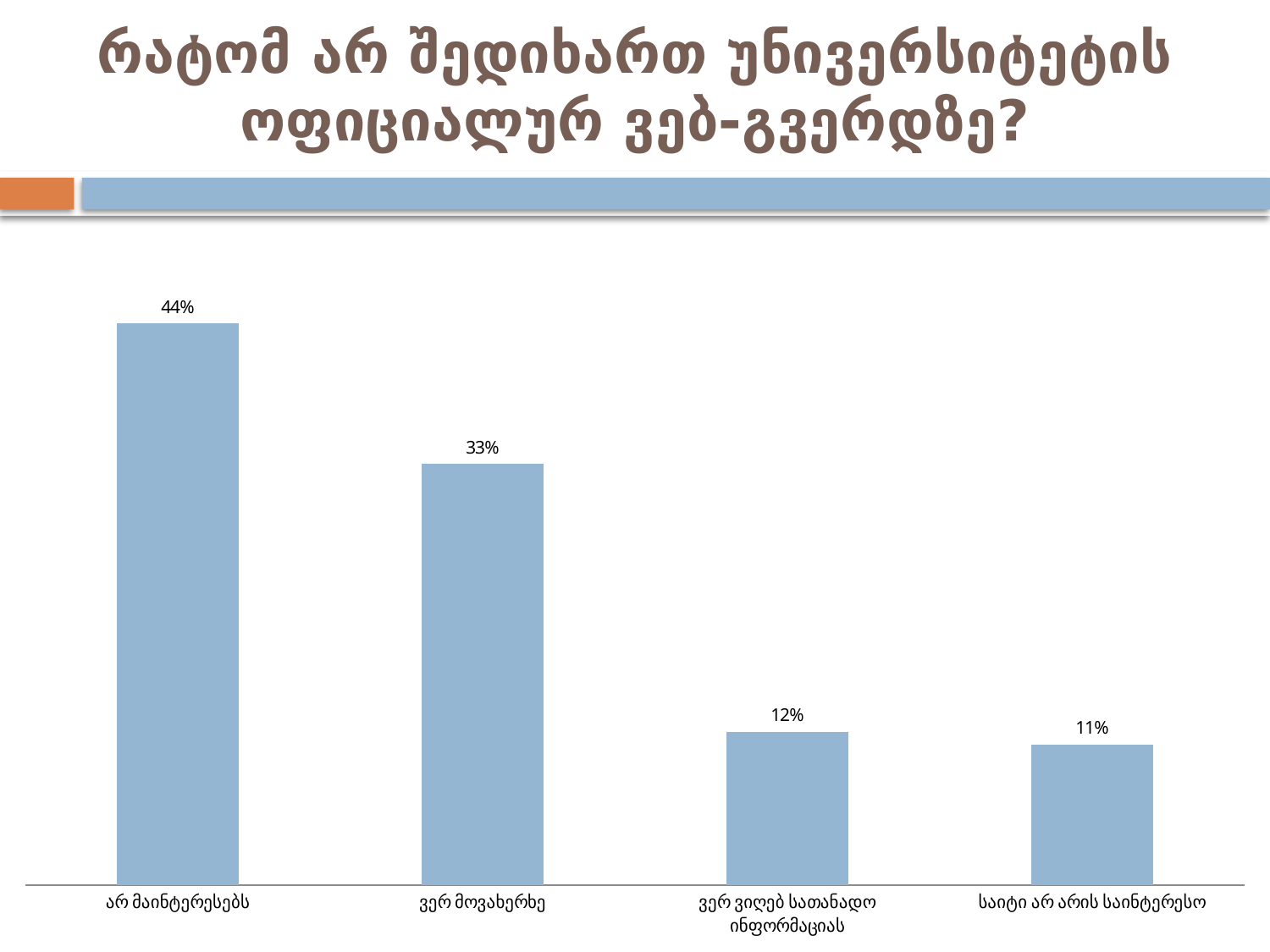
What is the value for "არ მაინტერესებს"? 44% Do the values rise or fall from left to right across the categories? Fall What is the difference between the values for "ვერ მოვახერხე" and "ვერ ვიღებ სათანადო ინფორმაციას"? 21% What kind of chart is shown on the slide? Bar chart Which category has the highest value? არ მაინტერესებს What is the value for "საიტი არ არის საინტერესო"? 11% Which category has the lowest value? საიტი არ არის საინტერესო Which is larger, the value for "ვერ მოვახერხე" or the value for "ვერ ვიღებ სათანადო ინფორმაციას"? ვერ მოვახერხე How many categories are shown in the chart? 4 What is the difference between the values for "არ მაინტერესებს" and "ვერ მოვახერხე"? 11% What is the value for "ვერ მოვახერხე"? 33% What is the value for "ვერ ვიღებ სათანადო ინფორმაციას"? 12%